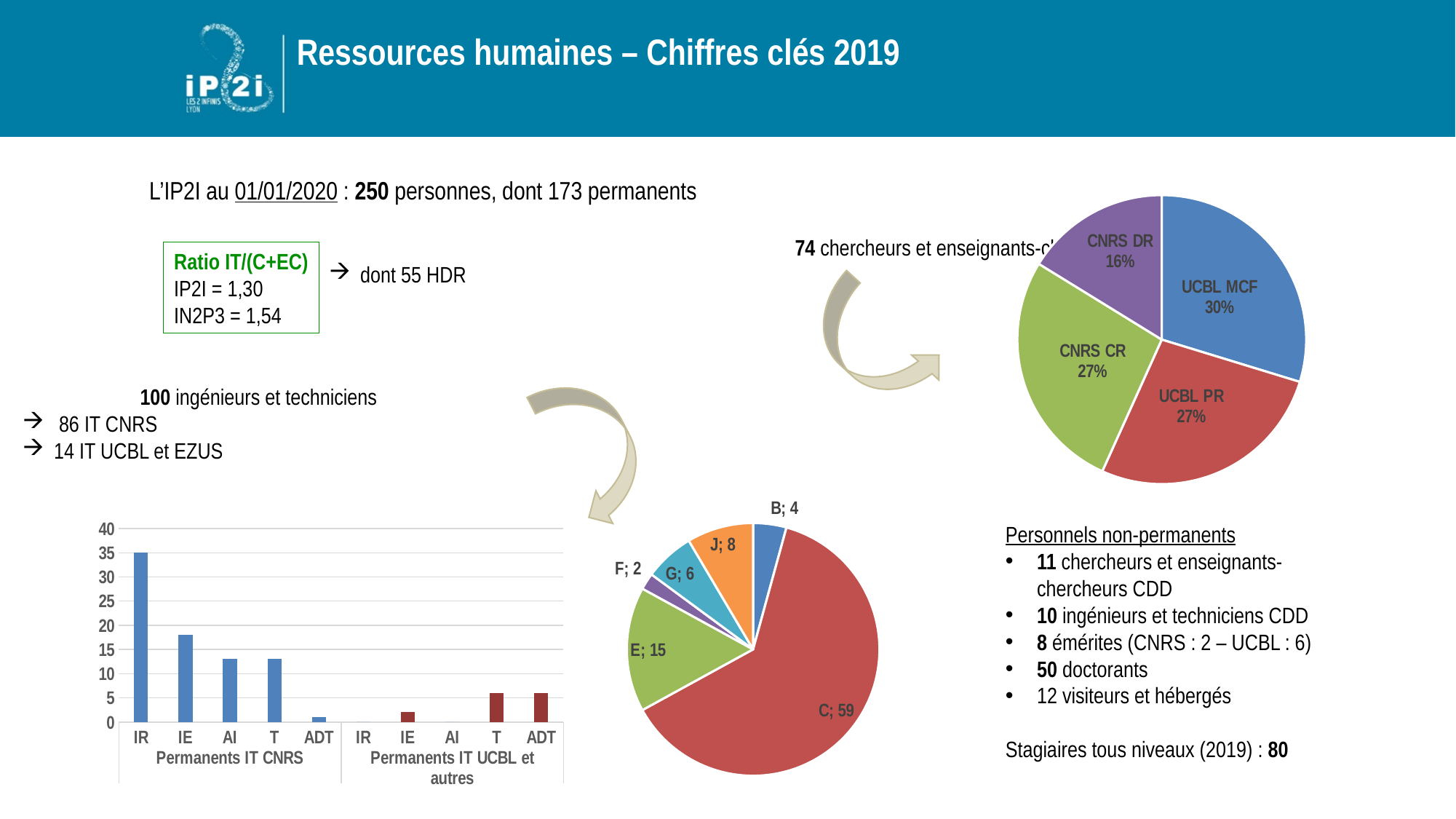
How many slices does the pie chart at the top right of the slide have? 4 In the pie chart at the bottom middle of the slide, what is the value for slice F? 2 In the pie chart at the top right of the slide, what is the difference in percentage points between UCBL MCF and CNRS DR? 14 In the pie chart at the bottom middle of the slide, which slice has the largest value? C In the pie chart at the bottom middle of the slide, which is larger, slice J or slice G? J In the pie chart at the top right of the slide, what percentage is shown for UCBL MCF? 30% In the pie chart at the bottom middle of the slide, what is the value for slice C? 59 In the pie chart at the top right of the slide, which category has the smallest share? CNRS DR In the pie chart at the bottom middle of the slide, what is the difference between the values of slices C and E? 44 In the pie chart at the top right of the slide, which category has the largest share? UCBL MCF In the bar chart at the bottom left of the slide, is the value for IR under Permanents IT CNRS greater or less than 30? greater What kind of chart is shown at the bottom left of the slide? bar chart